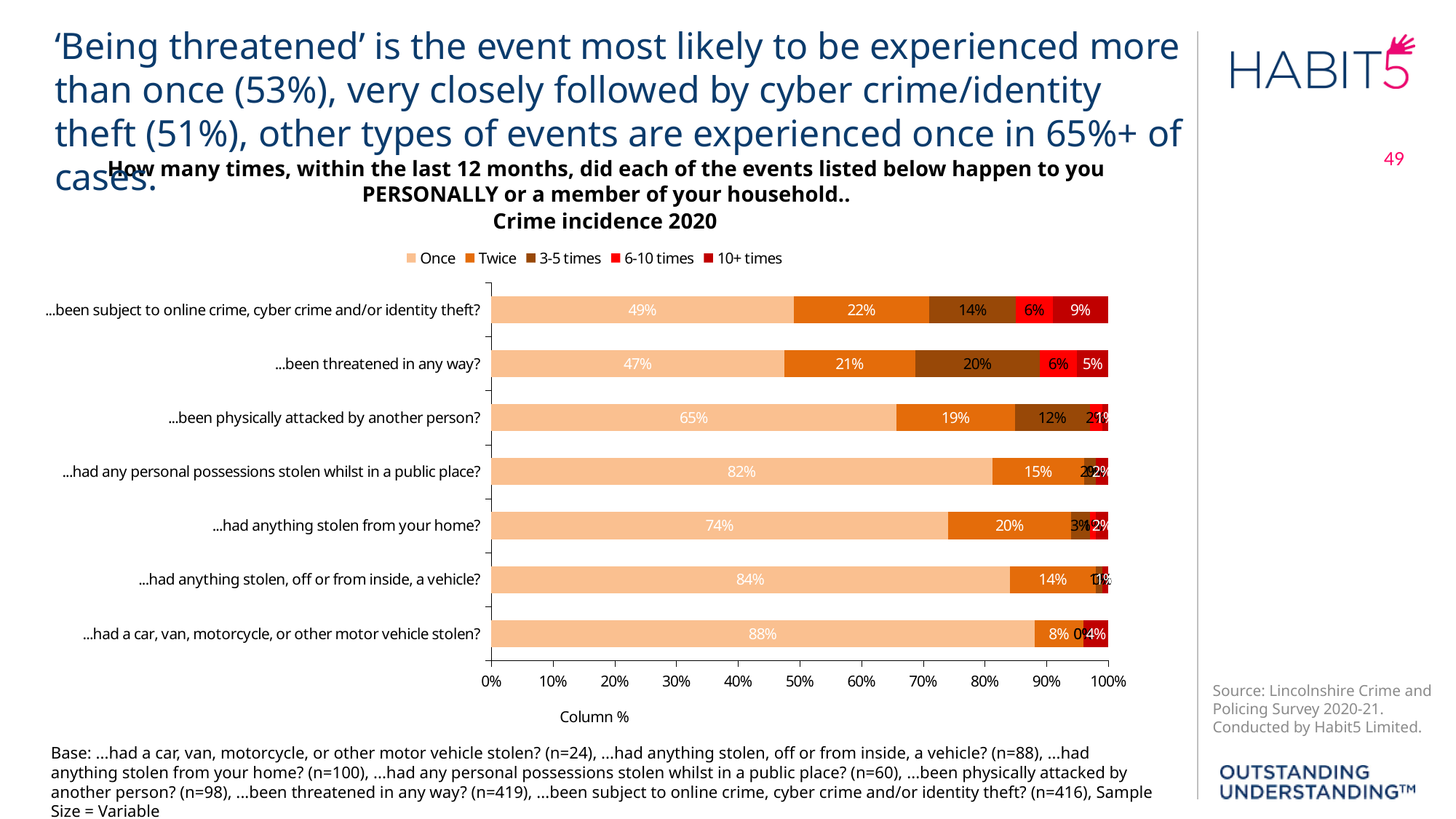
What is the 'Once' value for '...been subject to online crime, cyber crime and/or identity theft?'? 49% Which has the larger 'Twice' value: '...been subject to online crime, cyber crime and/or identity theft?' or '...been physically attacked by another person?'? ...been subject to online crime, cyber crime and/or identity theft? What is the 'Twice' value for '...been threatened in any way?'? 21% How many series does the legend list? 5 What is the '10+ times' value for '...been subject to online crime, cyber crime and/or identity theft?'? 9% What is the difference between the 'Once' values for '...had anything stolen, off or from inside, a vehicle?' and '...had anything stolen from your home?'? 10% Which event has the lowest 'Once' value? ...been threatened in any way? Which event has the highest 'Once' value? ...had a car, van, motorcycle, or other motor vehicle stolen? How many event categories are plotted in the chart? 7 What is the first entry in the chart's legend? Once What is the '3-5 times' value for '...been threatened in any way?'? 20% What kind of chart is shown on the slide? bar chart